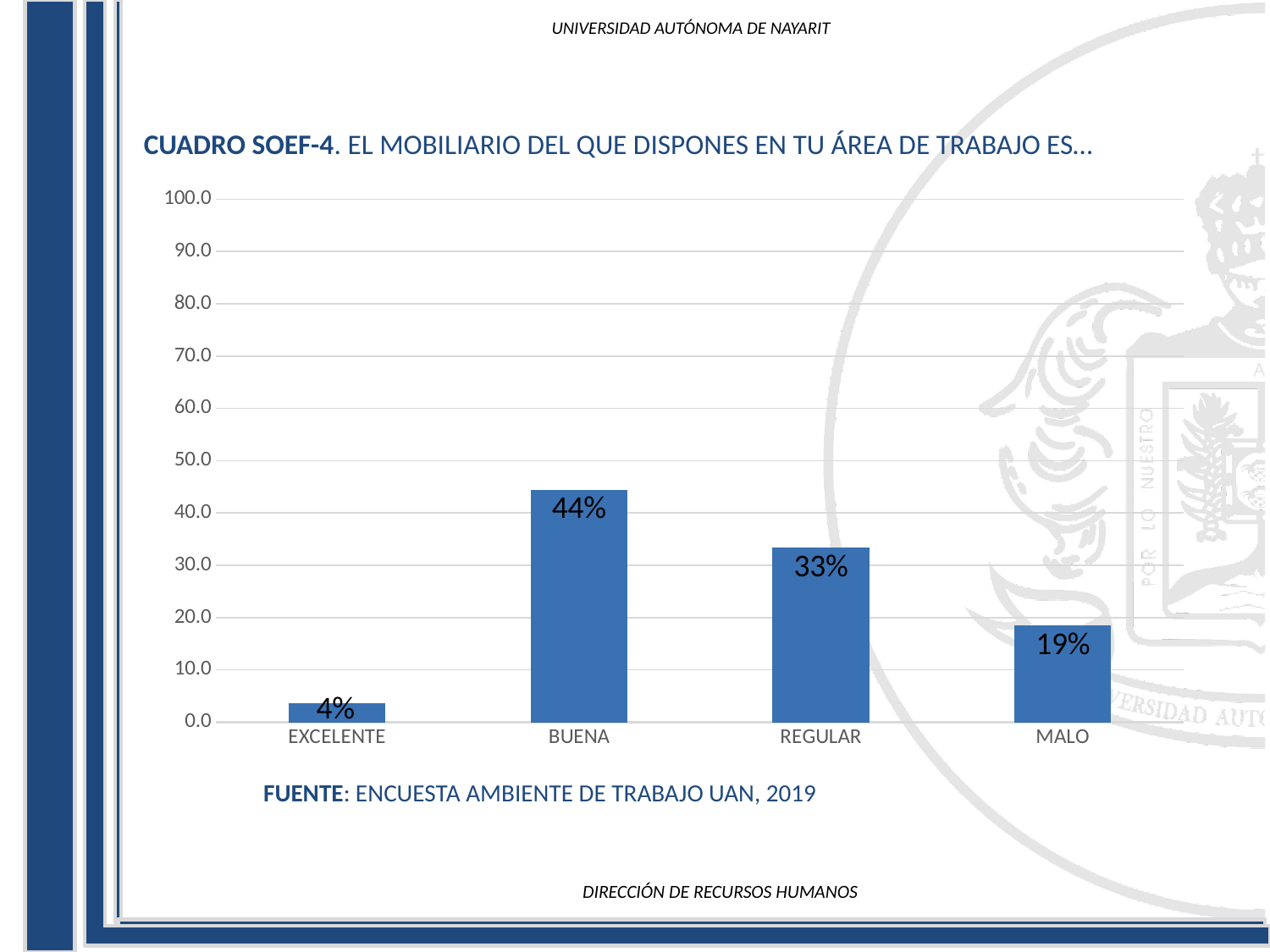
What is the value for EXCELENTE? 4% What kind of chart is shown on the slide? bar chart What is the value for MALO? 19% Which category has the highest value? BUENA Which is larger, the value for REGULAR or the value for MALO? REGULAR What is the value for BUENA? 44% Is the value for MALO greater or less than 20.0? less What is the value for REGULAR? 33% What is the difference between the values for BUENA and REGULAR? 11% Which category has the lowest value? EXCELENTE What source is cited below the chart? ENCUESTA AMBIENTE DE TRABAJO UAN, 2019 How many categories are shown on the x axis? 4